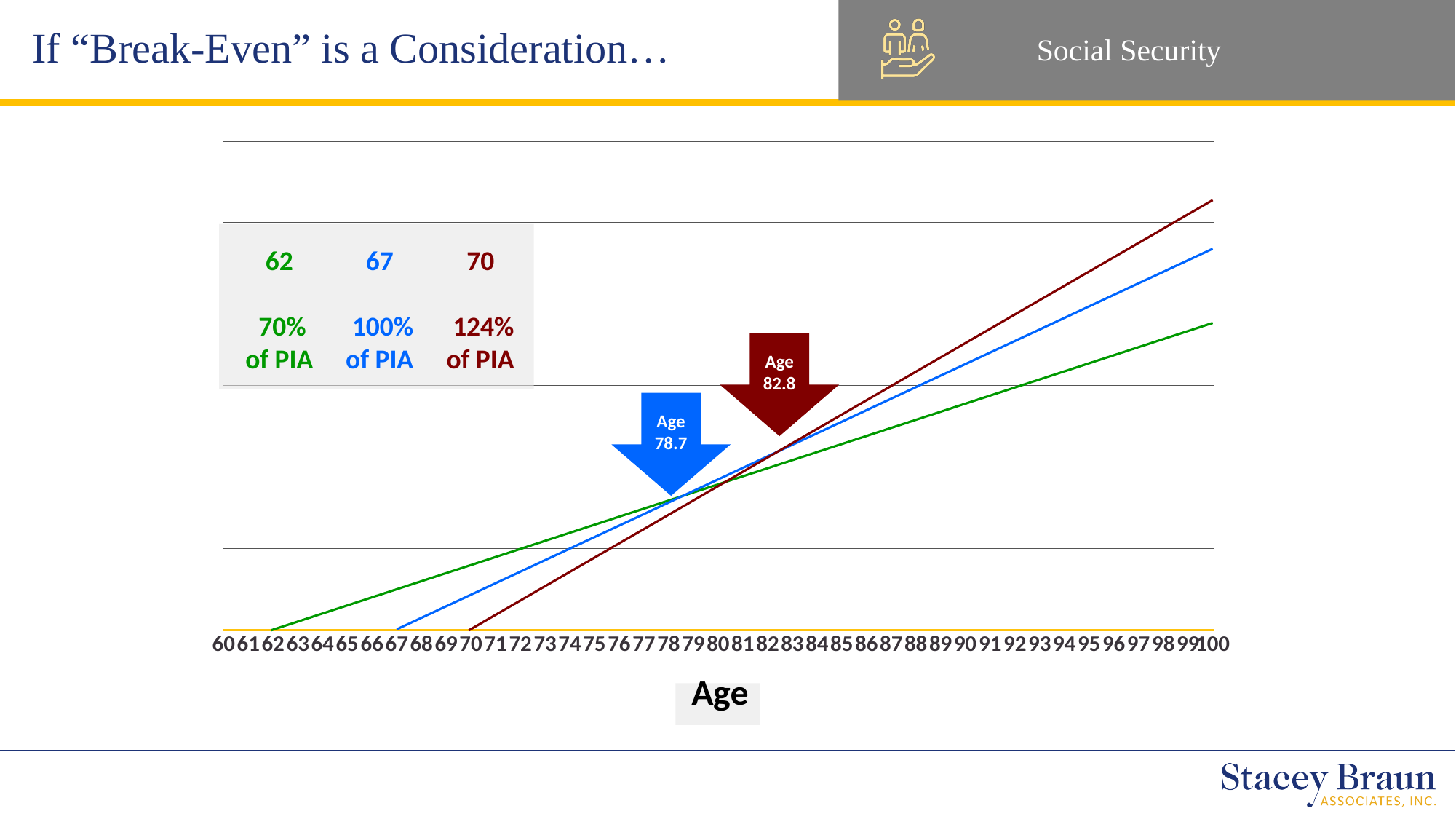
What age does the dark red arrow annotation point to? 82.8 What percentage of PIA is shown for claiming at age 62? 70% of PIA How many lines are plotted on the chart? 3 Do the plotted lines rise or fall as age increases along the x axis? rise Which line is lowest at age 100: the green, blue, or dark red line? green Which line is highest at age 100: the green, blue, or dark red line? dark red What percentage of PIA is shown for claiming at age 67? 100% of PIA What is the label of the x axis? Age What kind of chart is shown on the slide? line chart What percentage of PIA is shown for claiming at age 70? 124% of PIA At what age does the green line begin rising from the x axis? 62 What age does the blue arrow annotation point to? 78.7